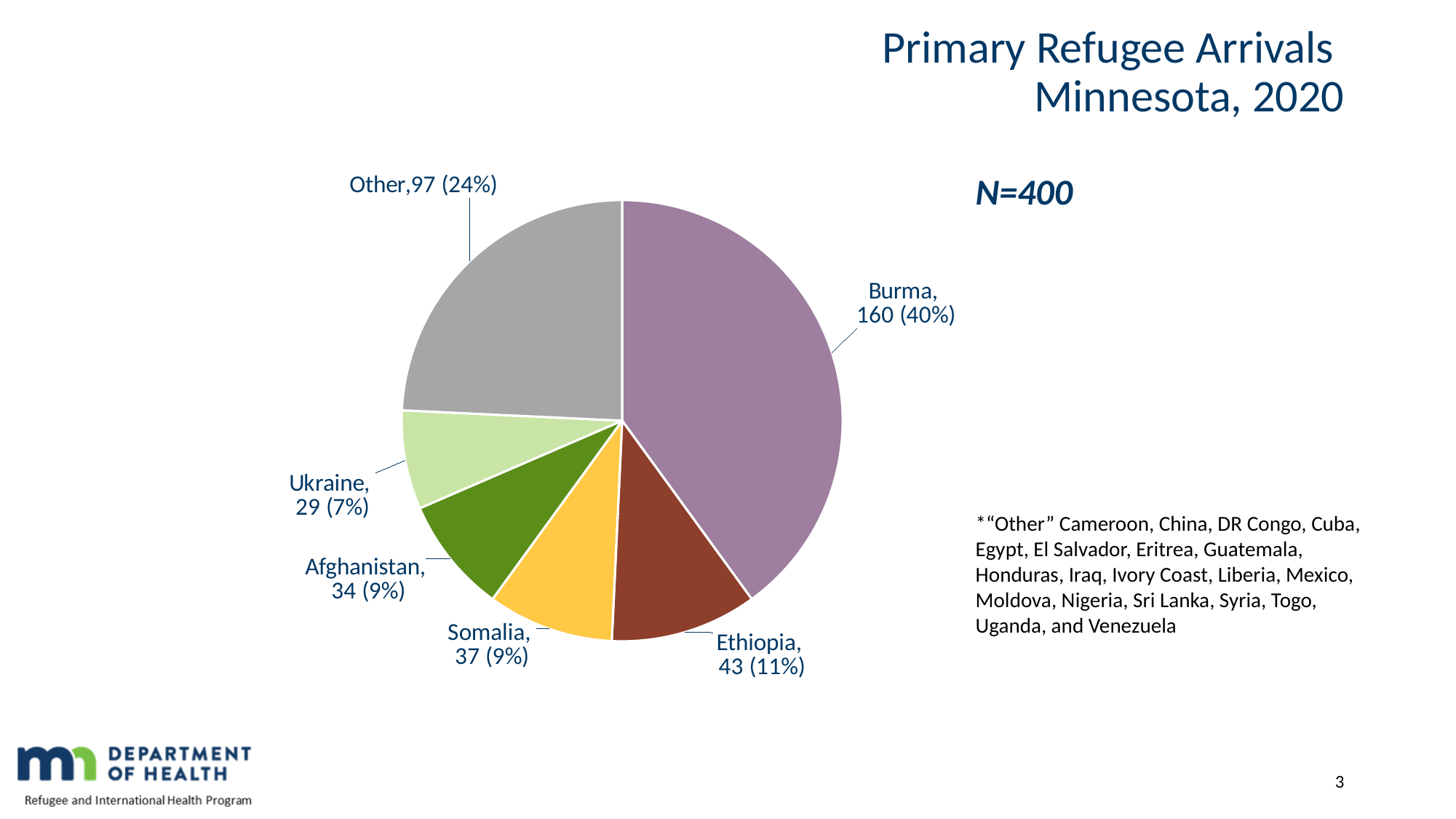
What share of the pie does the Other category represent? 24% What share of the pie does Ethiopia represent? 11% What is the total N shown on the slide? N=400 How many primary refugee arrivals from Burma are shown? 160 Which named country has the smallest slice of the pie? Ukraine What is the difference in arrivals between Burma and Other? 63 How many arrivals are shown for Ukraine? 29 Which has more arrivals, Somalia or Afghanistan? Somalia What is the title of the chart? Primary Refugee Arrivals Minnesota, 2020 Which category has the largest slice of the pie? Burma What kind of chart is shown on the slide? pie chart How many slices does the pie chart have? 6